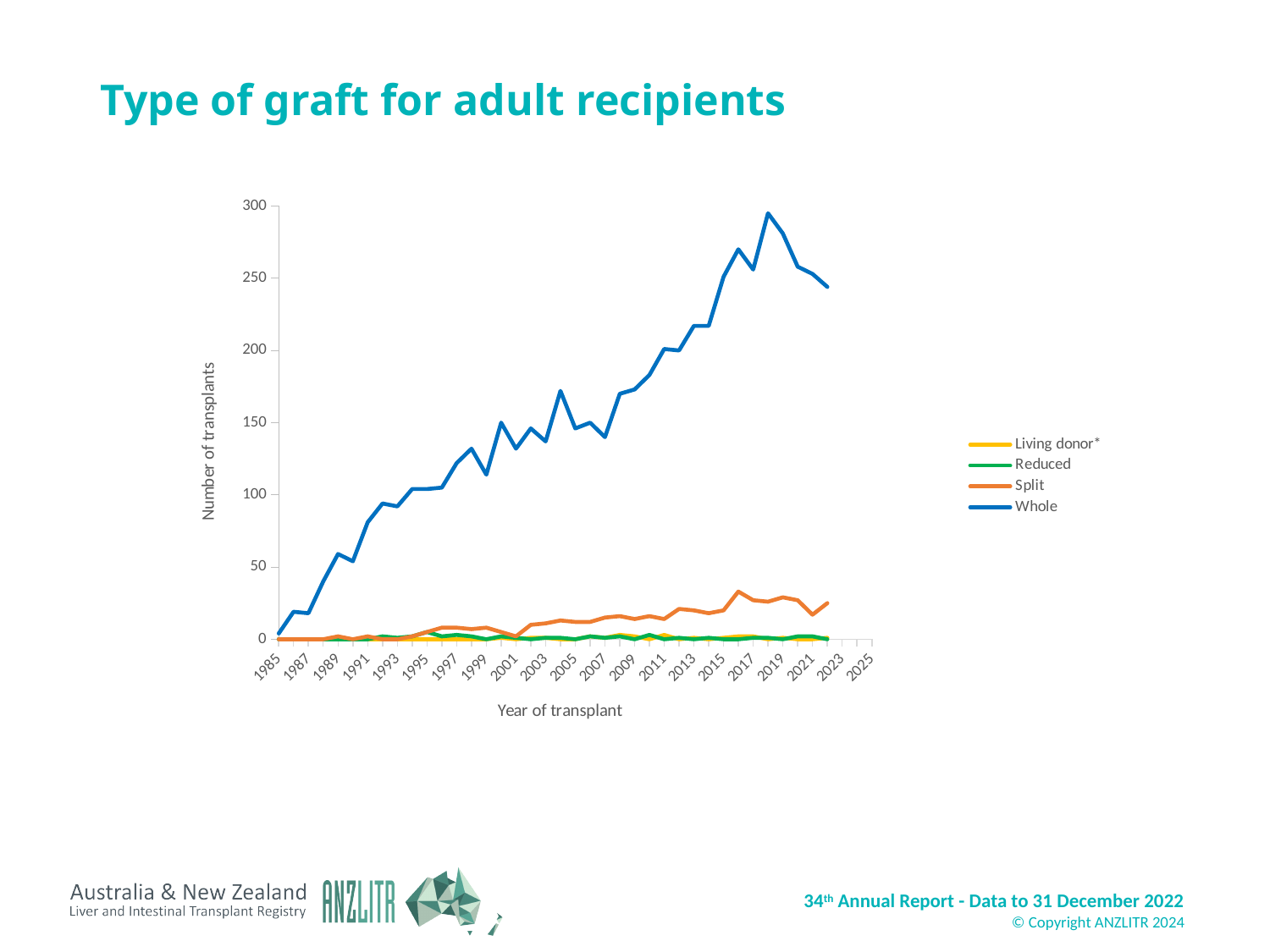
Is the value for Split in 2016 greater or less than 50? less Is the value for Whole in 1987 greater or less than 50? less Does the Whole series generally rise or fall from 1985 to 2018? rise Which series has the highest number of transplants across the chart? Whole What kind of chart is shown on the slide? Line chart Is the value for Whole in 2005 greater or less than 100? greater How many series does the legend list? 4 What is the title of the chart? Type of graft for adult recipients Which is larger in 2021, the value for Whole or the value for Split? Whole What is the label of the y axis? Number of transplants